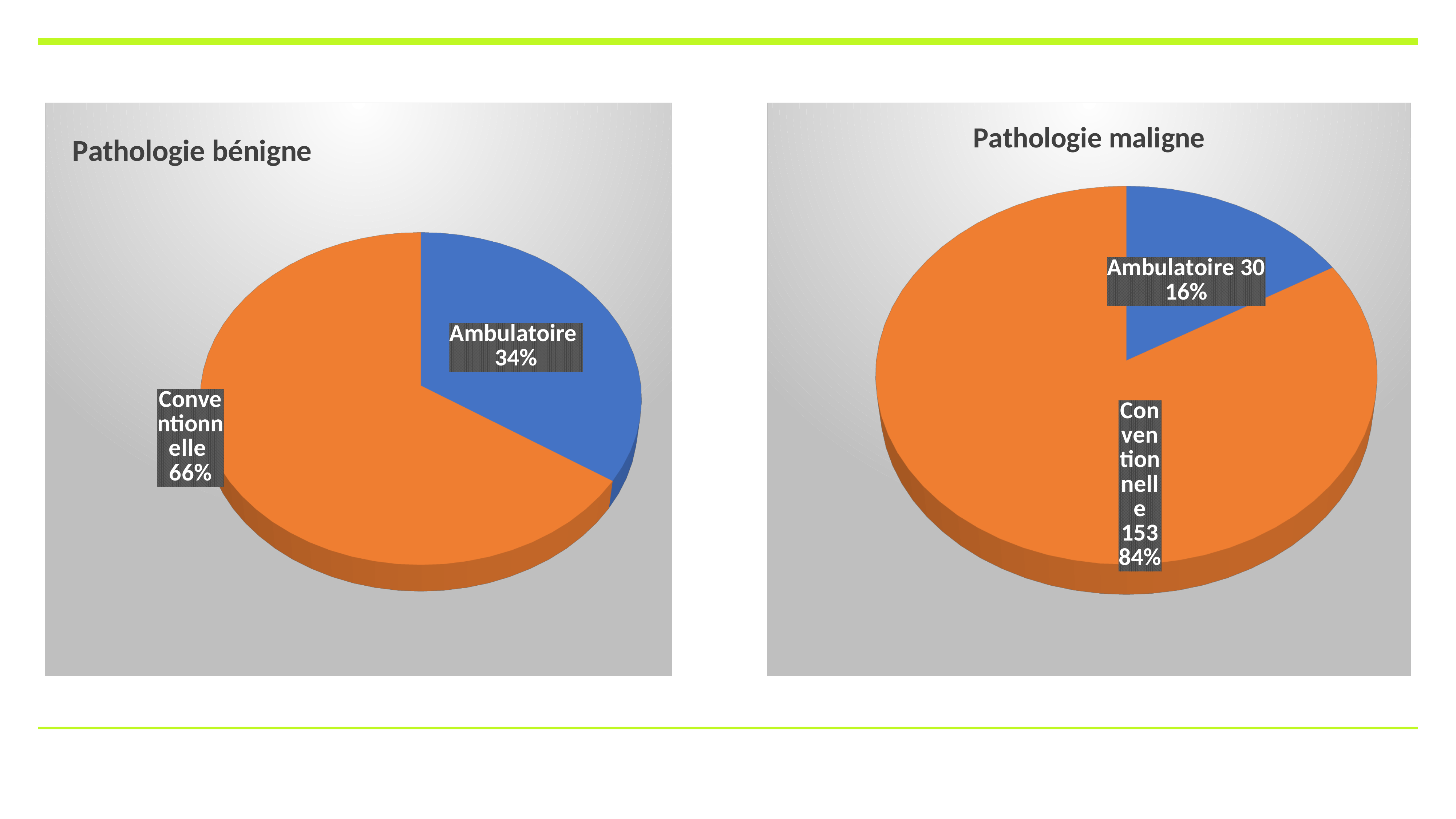
In the 'Pathologie maligne' chart, what is the value for Ambulatoire? 30 What kind of chart is the 'Pathologie bénigne' chart? Pie chart In the 'Pathologie maligne' chart, which slice is the smallest? Ambulatoire In the 'Pathologie maligne' chart, what is the total of the Ambulatoire and Conventionnelle values? 183 In the 'Pathologie bénigne' chart, which slice is the largest? Conventionnelle In the 'Pathologie maligne' chart, what share of the pie is Conventionnelle? 84% In the 'Pathologie maligne' chart, what is the difference between the Conventionnelle and Ambulatoire values? 123 How many slices does the 'Pathologie maligne' chart have? 2 In the 'Pathologie bénigne' chart, what share of the pie is Ambulatoire? 34% In the 'Pathologie maligne' chart, what share of the pie is Ambulatoire? 16% In the 'Pathologie maligne' chart, what is the value for Conventionnelle? 153